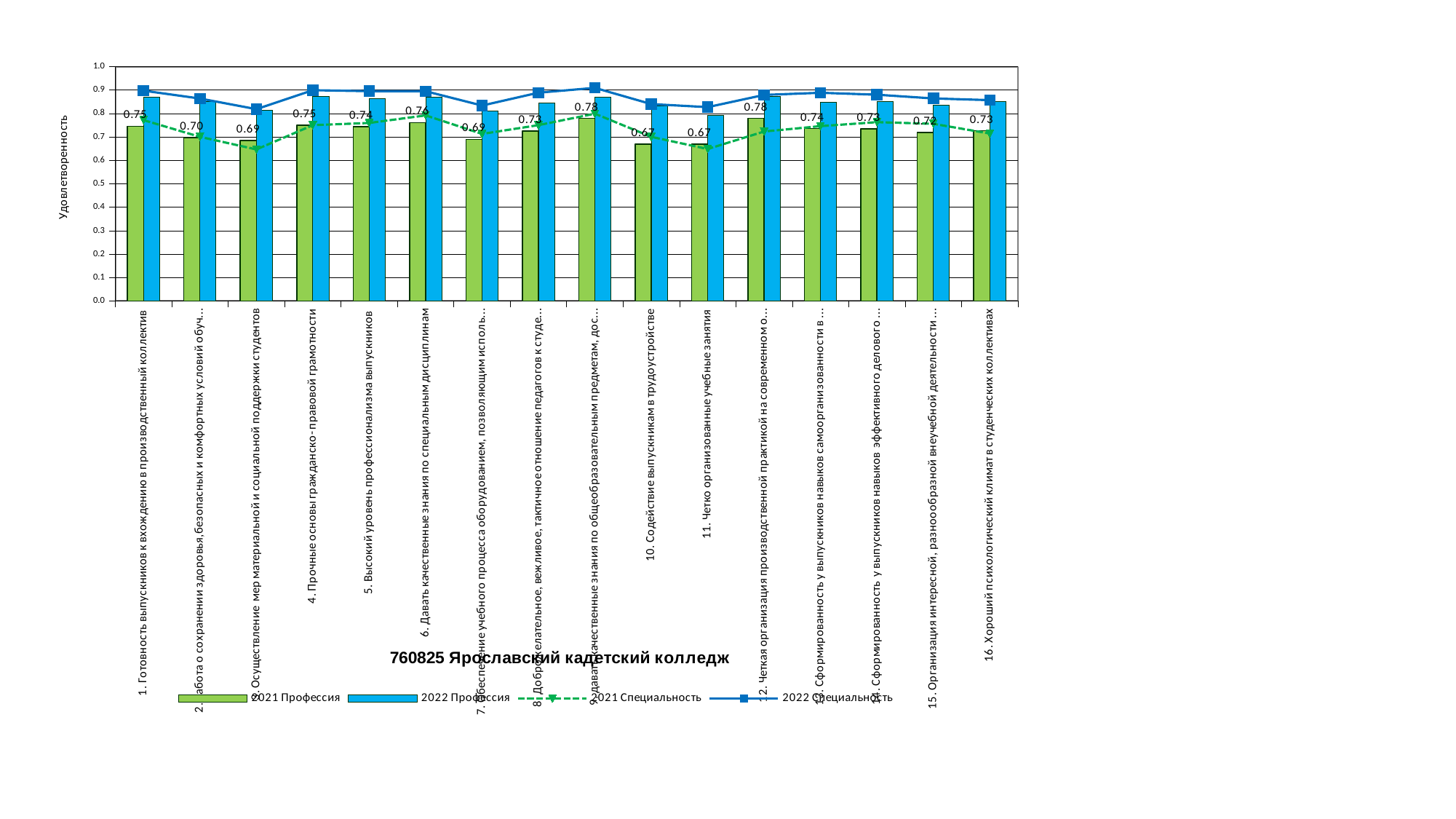
Is the 2022 Профессия value for category 4 greater or less than 0.8? greater What is the difference between the 2021 Профессия values for category 9 and category 10? 0.11 What is the highest labelled value of the 2021 Профессия series? 0.78 Is the 2022 Профессия value for category 1 greater or less than 0.8? greater How many categories are shown on the x axis? 16 Which has the larger 2021 Профессия value: category 1 or category 2? Category 1 What is the value of 2021 Профессия for category 10 (Содействие выпускникам в трудоустройстве)? 0.67 What is the label of the vertical axis? Удовлетворенность How many series does the legend list? 4 What is the value of 2021 Профессия for category 16 (Хороший психологический климат в студенческих коллективах)? 0.73 What is the value of 2021 Профессия for category 1 (Готовность выпускников к вхождению в производственный коллектив)? 0.75 What is the lowest labelled value of the 2021 Профессия series? 0.67